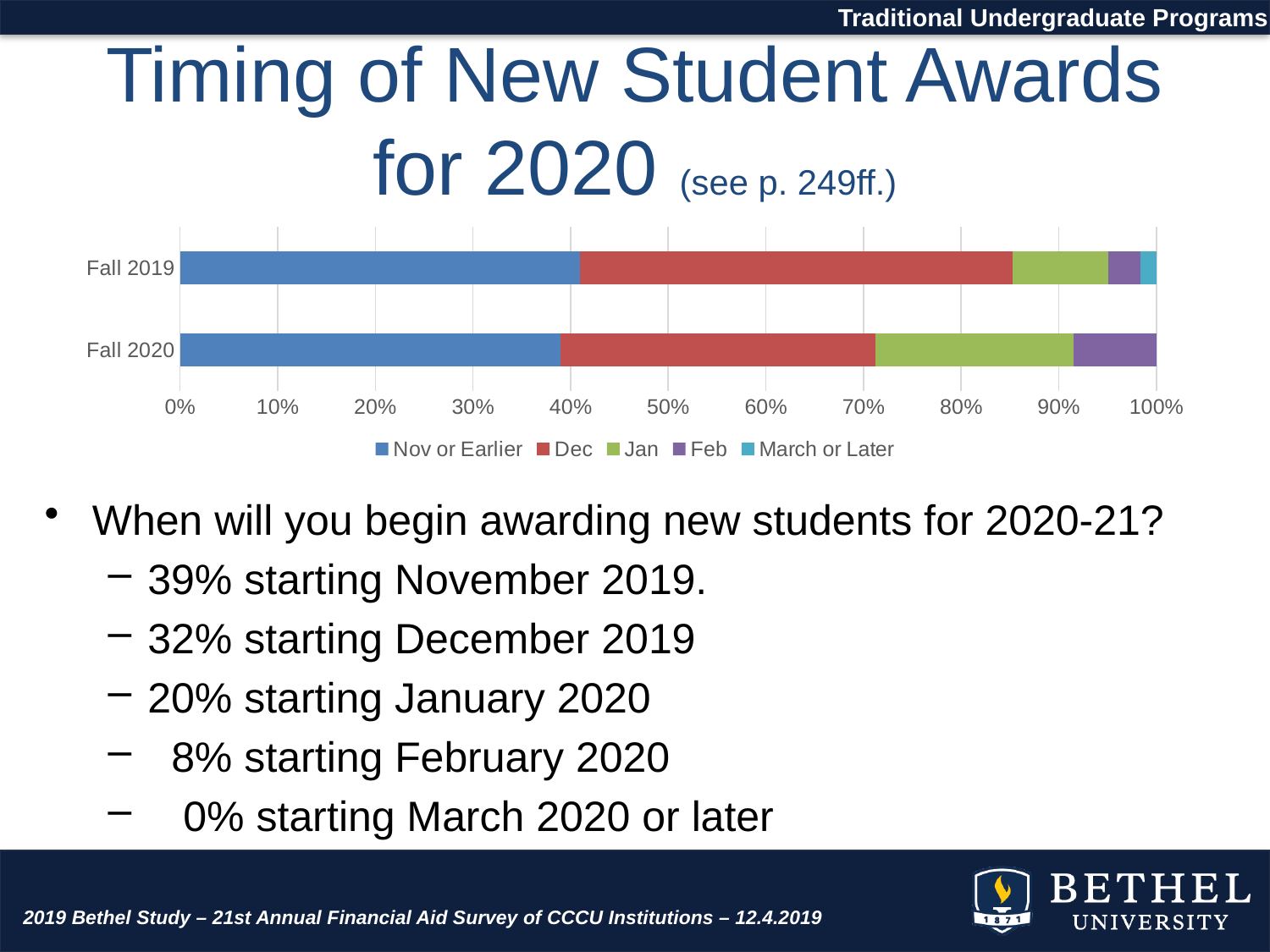
Is the Nov or Earlier value for Fall 2019 greater or less than 30%? greater Is the Feb segment larger for Fall 2019 or for Fall 2020? Fall 2020 Which series is shown in blue in the chart legend? Nov or Earlier According to the slide, what share of institutions will start awarding new students for Fall 2020 in March or later? 0% Is the Dec segment larger for Fall 2019 or for Fall 2020? Fall 2019 Is the Jan segment larger for Fall 2019 or for Fall 2020? Fall 2020 What kind of chart is shown on the slide? Stacked bar chart Which series is shown in red in the chart legend? Dec How many series does the chart legend list? 5 How many categories (bars) does the chart show? 2 According to the slide, what share of institutions will start awarding new students for Fall 2020 in November or earlier? 39% According to the slide, what share of institutions will start awarding new students for Fall 2020 in January? 20%